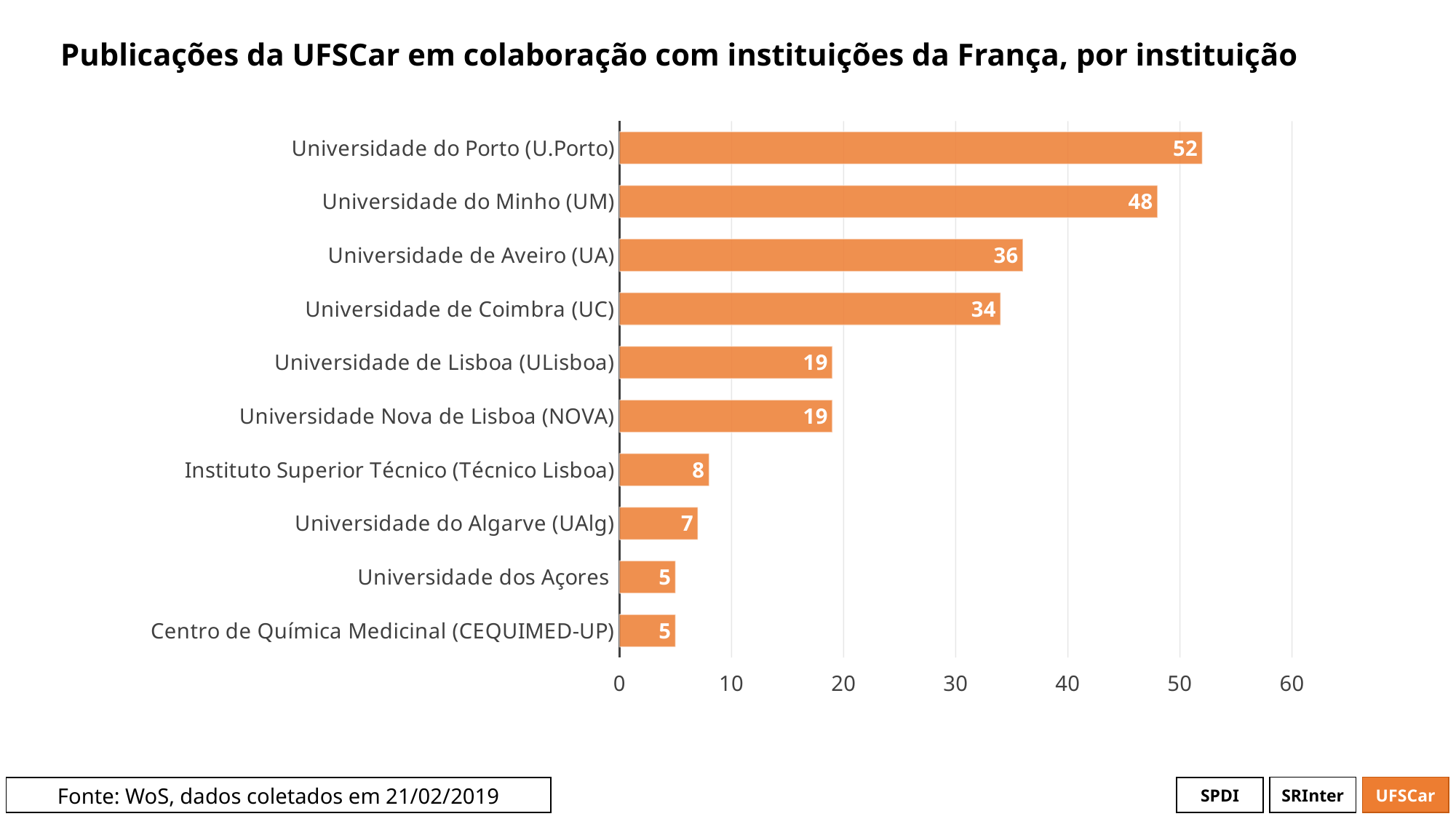
What is the value for Universidade do Porto (U.Porto)? 52 Which is larger, Universidade de Aveiro (UA) or Universidade de Coimbra (UC)? Universidade de Aveiro (UA) What is the value for Universidade do Algarve (UAlg)? 7 Is the value for Universidade do Minho (UM) greater or less than 40? greater Which is larger, Instituto Superior Técnico (Técnico Lisboa) or Universidade dos Açores? Instituto Superior Técnico (Técnico Lisboa) What is the title of the chart? Publicações da UFSCar em colaboração com instituições da França, por instituição What is the value for Universidade de Coimbra (UC)? 34 Which institution has the highest number of publications? Universidade do Porto (U.Porto) What kind of chart is shown on the slide? bar chart What is the difference between Universidade do Porto (U.Porto) and Universidade do Minho (UM)? 4 How many institutions are shown in the chart? 10 What is the difference between Universidade de Aveiro (UA) and Universidade de Lisboa (ULisboa)? 17